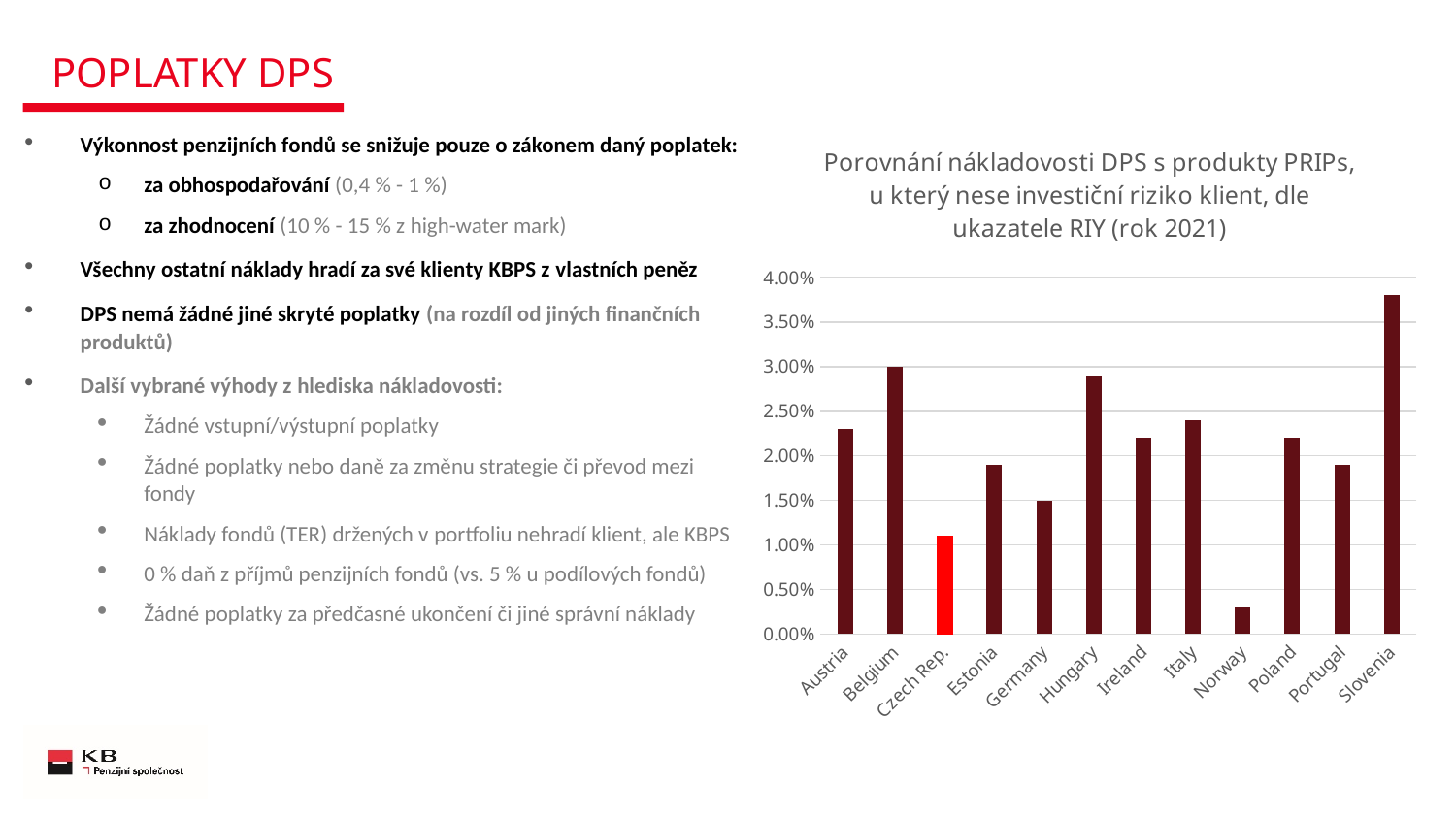
How many countries are shown on the x axis of the chart? 12 Which country's bar is coloured red instead of dark red in the chart? Czech Rep. Which country has the lowest value in the chart? Norway Is the value for Hungary greater or less than 2.50%? greater Is the value for Norway greater or less than 0.50%? less Which has a larger value, Italy or Germany? Italy Is the value for Estonia greater or less than 2.00%? less Which has a larger value, Belgium or Czech Rep.? Belgium What kind of chart is shown on the slide? bar chart Which country has the highest value in the chart? Slovenia